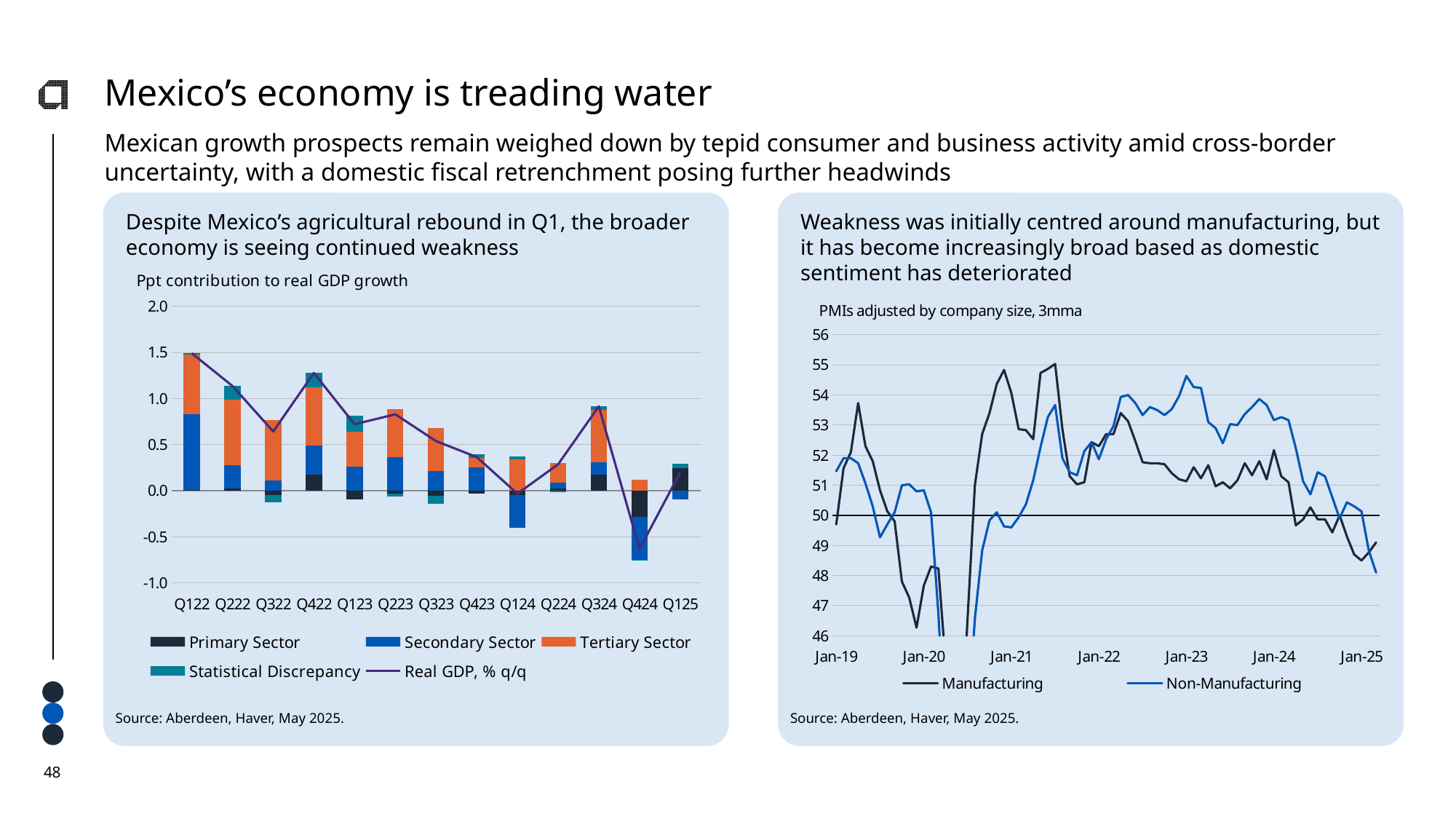
In the left chart 'Ppt contribution to real GDP growth', how many quarters are shown on the x axis? 13 In the left chart 'Ppt contribution to real GDP growth', is the Real GDP, % q/q value for Q424 greater or less than 0.0? less In the right chart 'PMIs adjusted by company size, 3mma', how many series does the legend list? 2 In the right chart 'PMIs adjusted by company size, 3mma', is the Manufacturing value at Jan-25 greater or less than 50? less In the left chart 'Ppt contribution to real GDP growth', how many entries does the legend list? 5 What kind of chart is the right chart titled 'PMIs adjusted by company size, 3mma'? Line chart In the right chart 'PMIs adjusted by company size, 3mma', do the Manufacturing and Non-Manufacturing series rise or fall between Jan-24 and Jan-25? fall In the right chart 'PMIs adjusted by company size, 3mma', which series is shown in black? Manufacturing In the left chart 'Ppt contribution to real GDP growth', is the Real GDP, % q/q value for Q122 greater or less than 1.0? greater In the left chart 'Ppt contribution to real GDP growth', in which quarter is Real GDP, % q/q highest? Q122 What kind of chart is the left chart titled 'Ppt contribution to real GDP growth'? Stacked bar chart with a line In the left chart 'Ppt contribution to real GDP growth', in which quarter is Real GDP, % q/q lowest? Q424